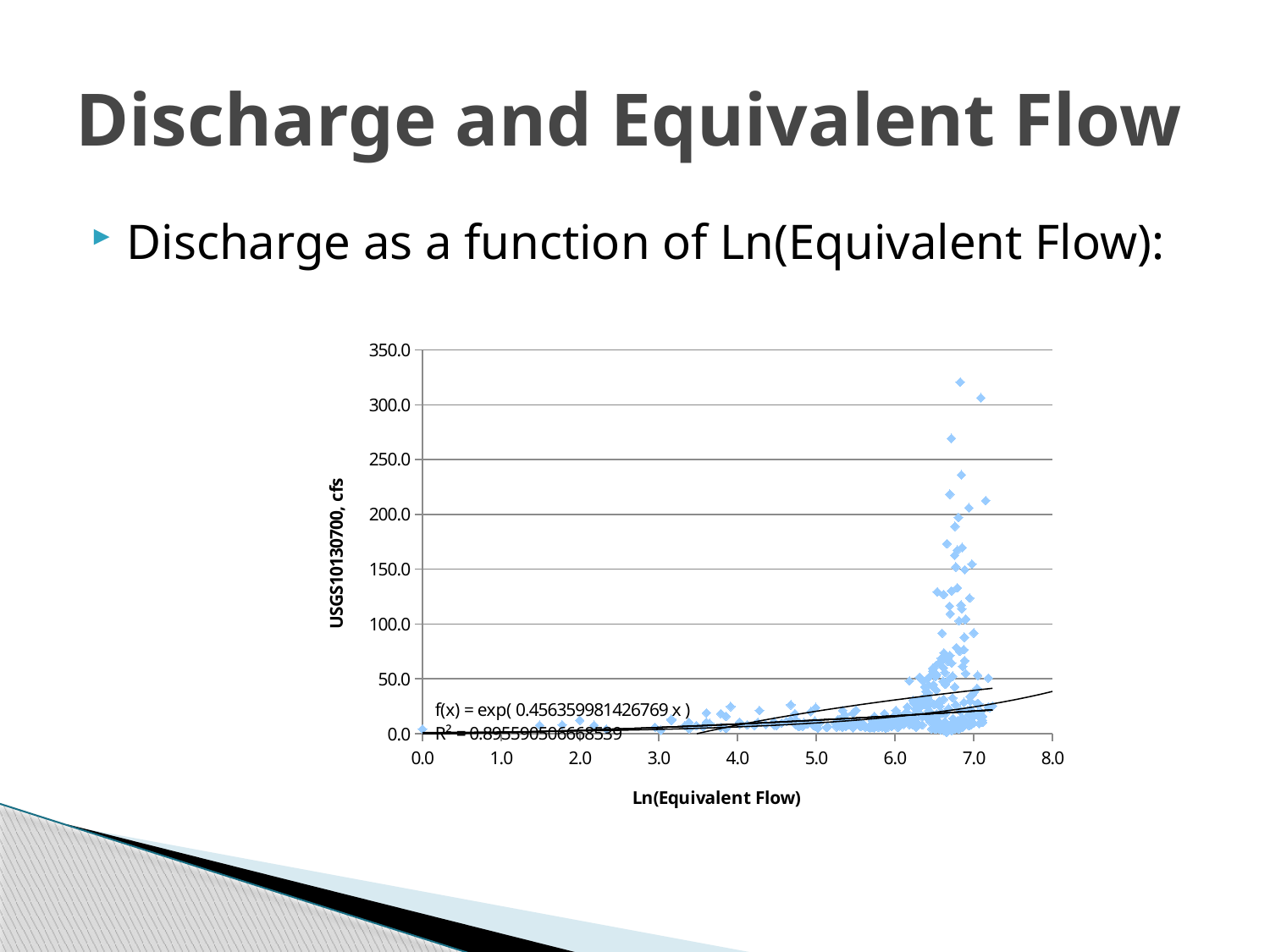
What kind of chart is shown on the slide? scatter chart Is the highest plotted discharge value on the chart greater or less than 300.0? greater What is the title of the x axis of the chart? Ln(Equivalent Flow) What is the fitted trendline equation printed on the chart? f(x) = exp( 0.456359981426769 x ) Are the discharge values for points with Ln(Equivalent Flow) below 4.0 greater or less than 50.0? less What is the maximum value shown on the x axis of the chart? 8.0 Around which x-axis value do the highest discharge points cluster: 3.0 or 7.0? 7.0 What is the title of the y axis of the chart? USGS10130700, cfs Do the plotted discharge values generally rise or fall as Ln(Equivalent Flow) increases along the x axis? rise What is the maximum value shown on the y axis of the chart? 350.0 What is the spacing between consecutive tick labels on the y axis of the chart? 50.0 Is the highest plotted discharge value on the chart greater or less than 350.0? less